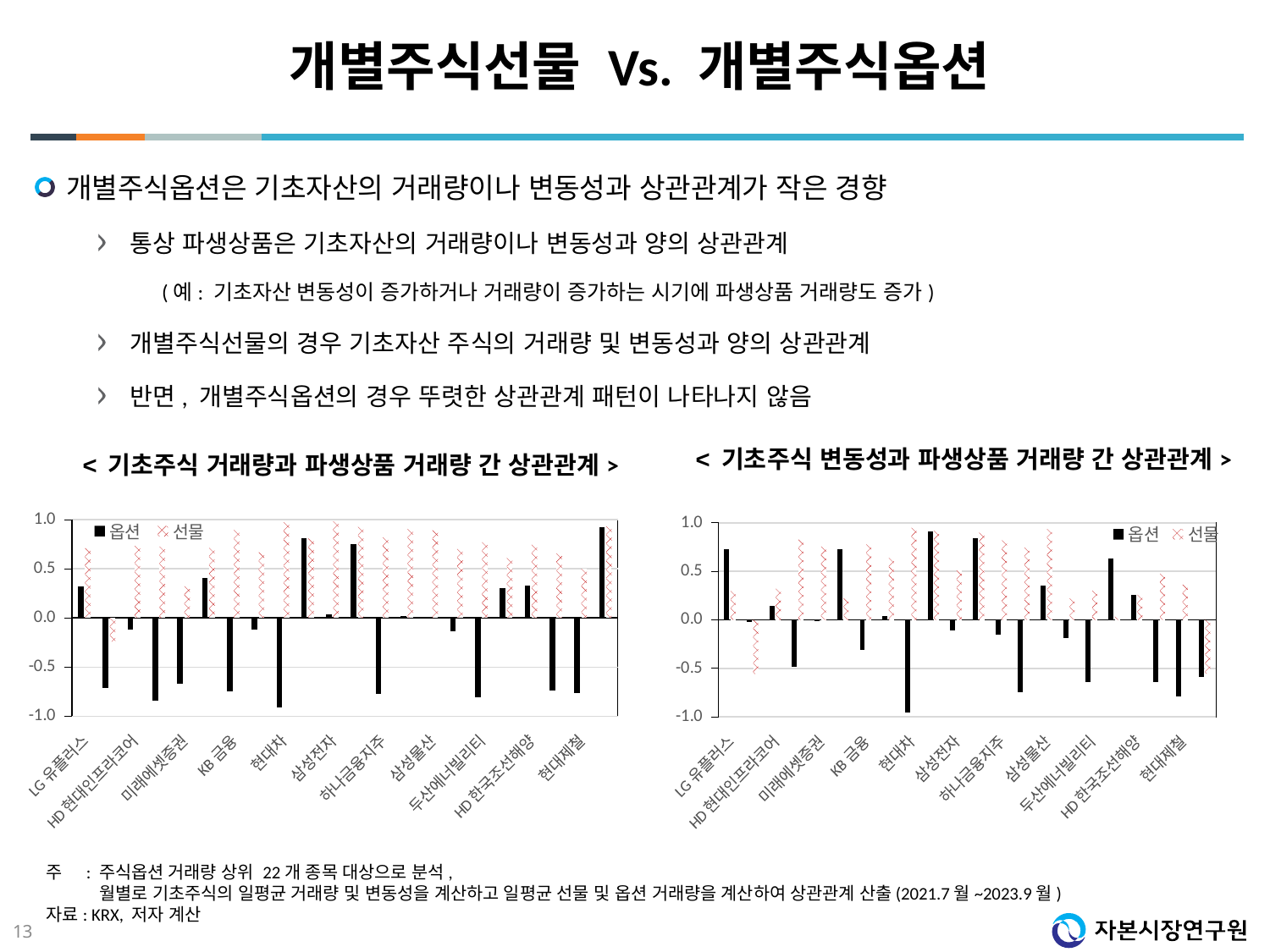
In the right chart, which series has the larger value for LG 유플러스, 옵션 or 선물? 옵션 In the left chart, is the 옵션 value for 현대차 greater or less than -0.5? less In the left chart, is the 옵션 value for LG 유플러스 greater or less than 0.0? greater In the left chart, how many category labels are printed along the x axis? 11 What kind of chart is the right chart titled '기초주식 변동성과 파생상품 거래량 간 상관관계'? bar chart In the right chart, is the 선물 value for LG 유플러스 greater or less than 0.5? less In the left chart, how many series does the legend list? 2 In the right chart, what are the two legend entries? 옵션, 선물 In the left chart, which series has the larger value for LG 유플러스, 옵션 or 선물? 선물 What kind of chart is the left chart titled '기초주식 거래량과 파생상품 거래량 간 상관관계'? bar chart